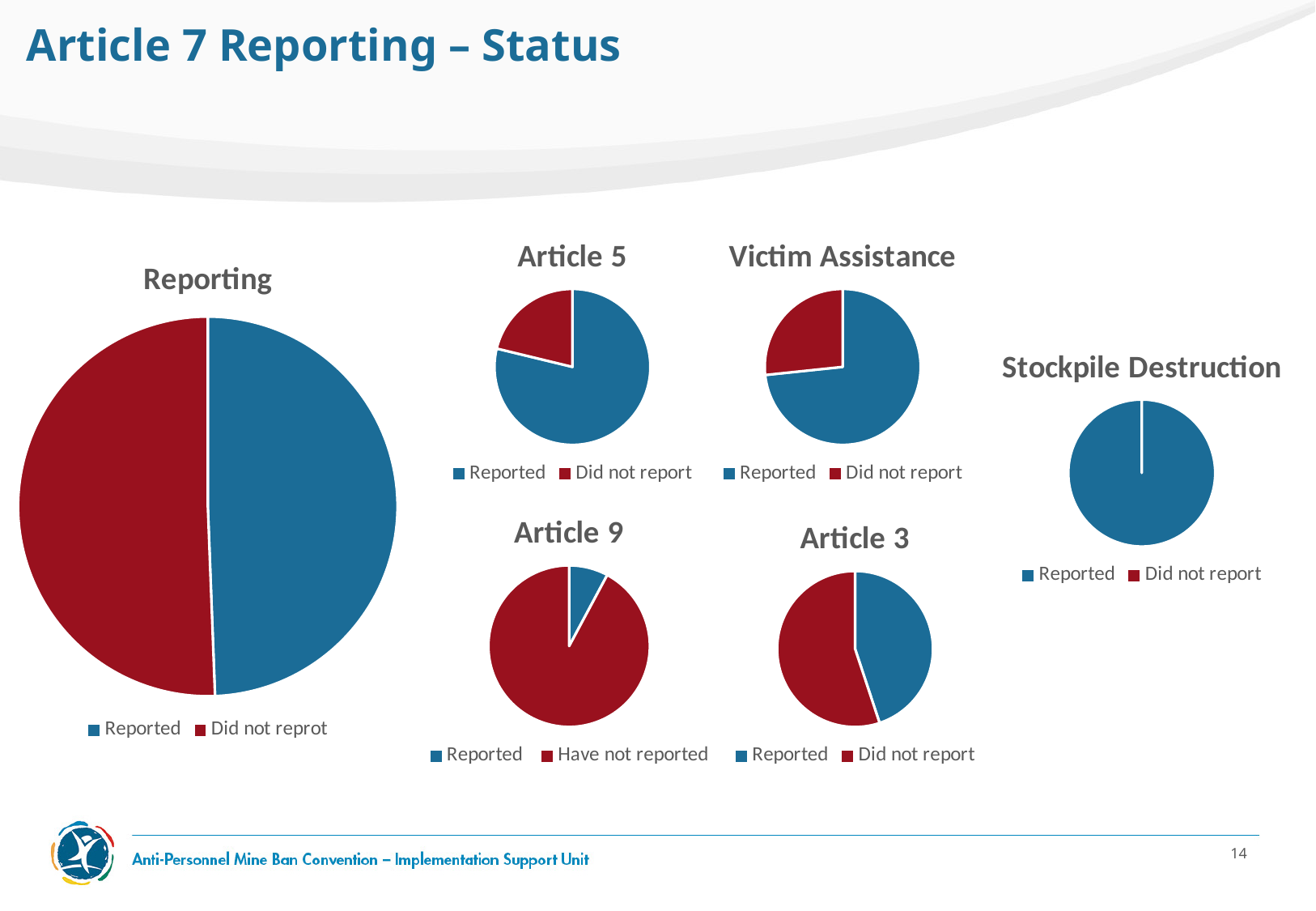
How many series does the legend of the "Stockpile Destruction" chart list? 2 In the "Article 3" chart, which slice is larger, Reported or Did not report? Did not report In the "Article 9" chart, which category has the smallest slice? Reported In the "Victim Assistance" chart, which slice is larger, Reported or Did not report? Reported What kind of chart is the "Reporting" chart? pie chart What are the two legend entries of the "Article 9" chart? Reported, Have not reported How many series does the legend of the "Article 5" chart list? 2 What colour represents "Did not report" in the "Victim Assistance" chart? red How many pie charts are shown on the slide? 6 In the "Article 9" chart, which slice is larger, Reported or Have not reported? Have not reported In the "Stockpile Destruction" chart, which category makes up the whole pie? Reported